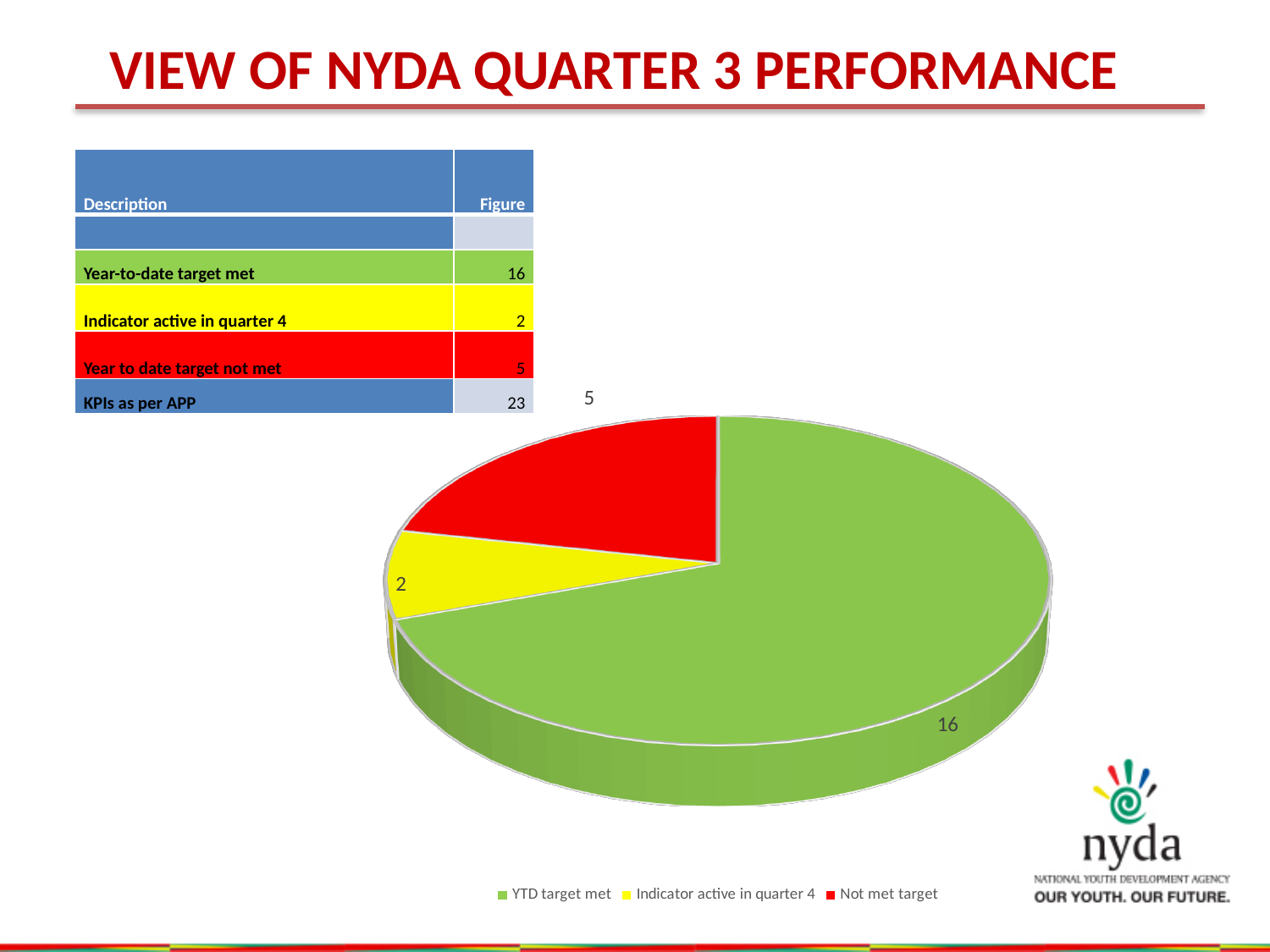
How many entries does the pie chart legend list? 3 How many slices does the pie chart have? 3 What is the value of the YTD target met slice in the pie chart? 16 What is the value of the Indicator active in quarter 4 slice in the pie chart? 2 What is the total of all slices in the pie chart? 23 What colour is the Not met target slice in the pie chart? red What is the difference between the YTD target met slice and the Not met target slice? 11 Which is larger in the pie chart: Not met target or Indicator active in quarter 4? Not met target Which slice of the pie chart is the smallest? Indicator active in quarter 4 What is the value of the Not met target slice in the pie chart? 5 What kind of chart is shown on the slide? pie chart Which slice of the pie chart is the largest? YTD target met